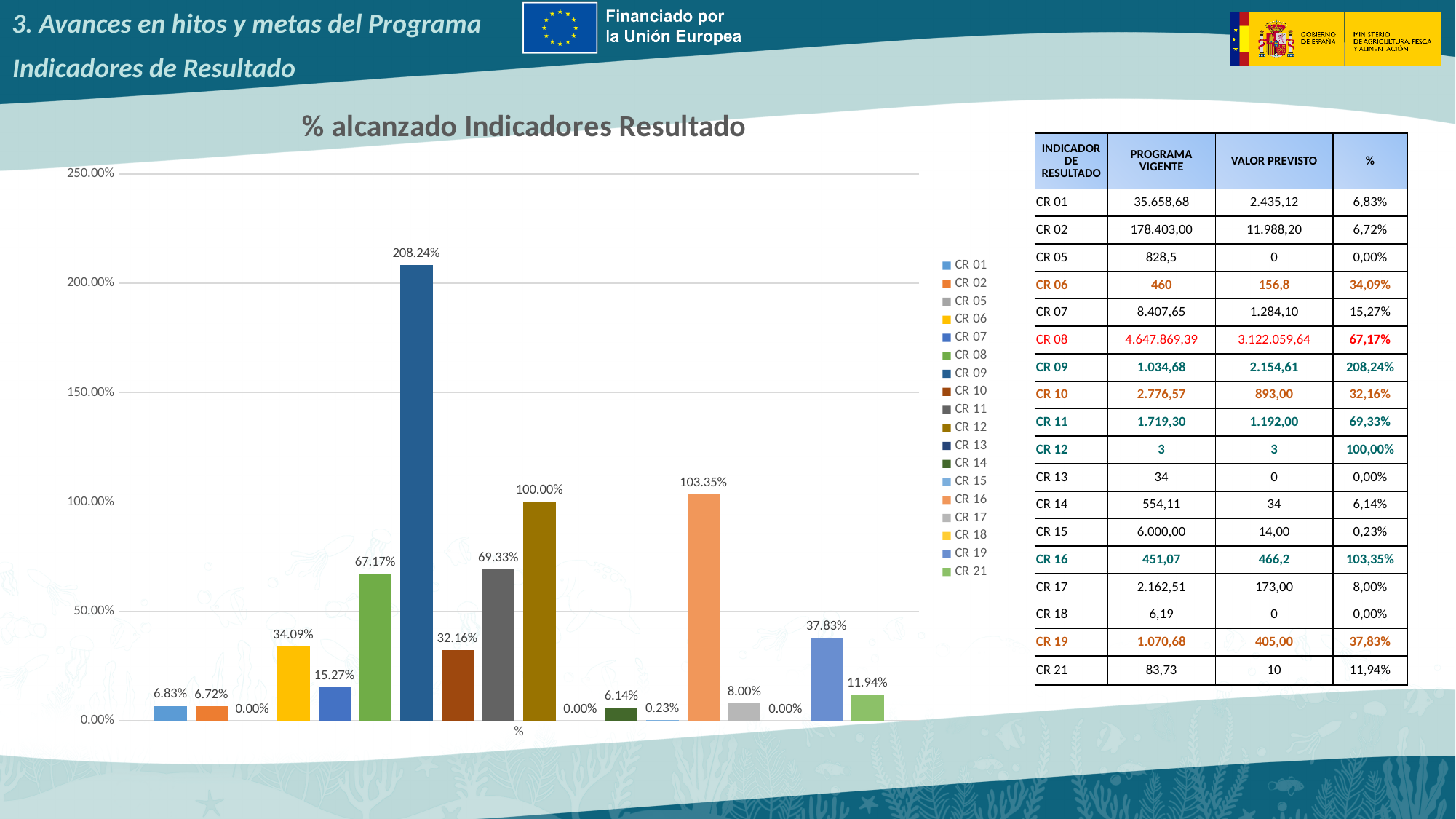
How many series does the chart legend list? 18 What is the title of the chart? % alcanzado Indicadores Resultado Which series has the highest value in the chart? CR 09 What is the difference between the values for CR 19 and CR 10? 5.67% Which is larger, the value for CR 08 or the value for CR 11? CR 11 What is the difference between the values for CR 09 and CR 16? 104.89% What is the value shown for CR 09 in the chart? 208.24% What is the value shown for CR 16 in the chart? 103.35% Is the value for CR 12 greater or less than 50.00%? greater What is the value shown for CR 06 in the chart? 34.09% What type of chart is shown on the slide? bar chart What is the value shown for CR 19 in the chart? 37.83%